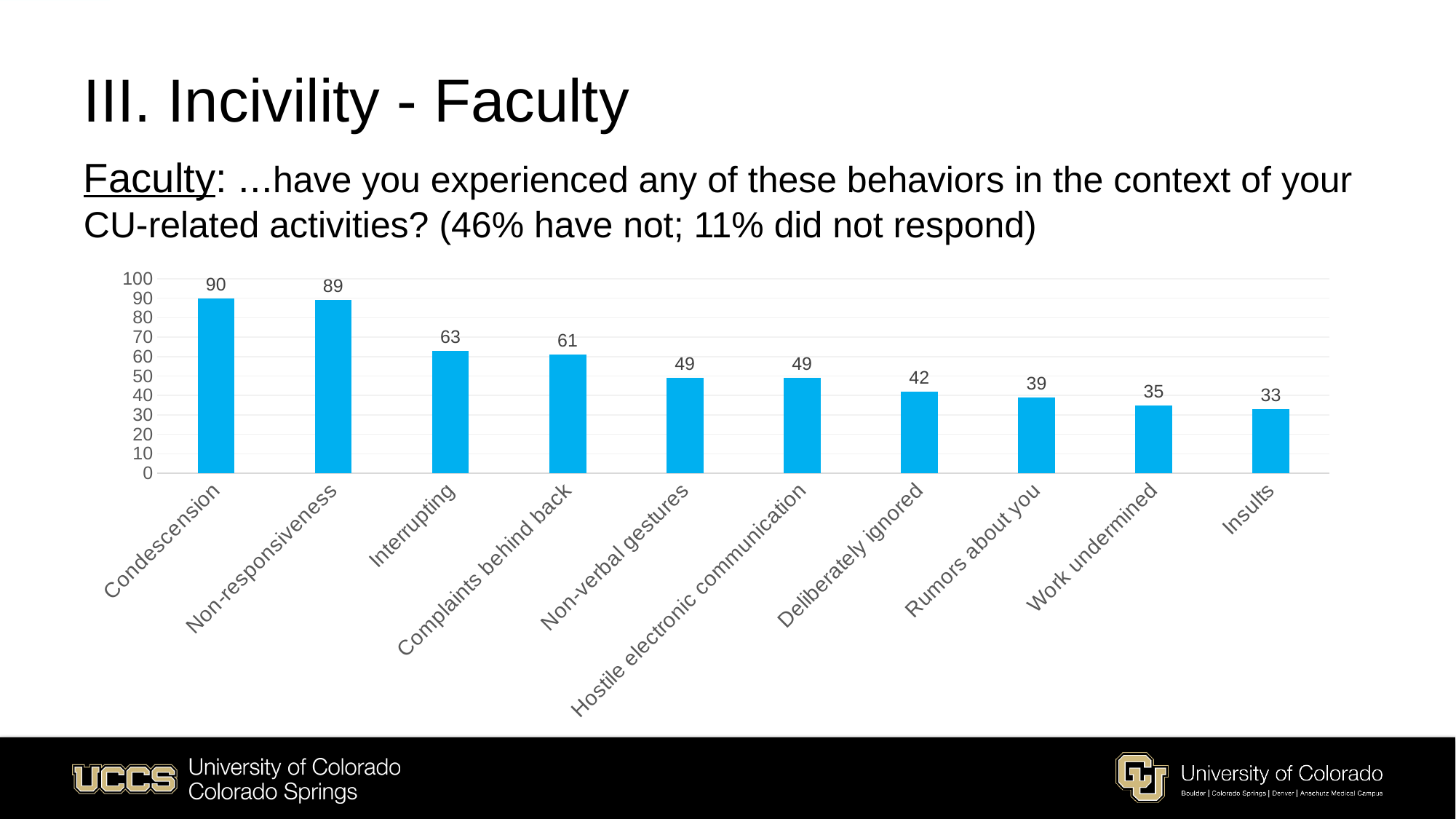
How many categories are shown in the chart? 10 Which category has the highest value? Condescension What is the difference between the values for Non-responsiveness and Deliberately ignored? 47 Do the values rise or fall from left to right along the x axis? fall What is the difference between the values for Interrupting and Insults? 30 What is the value for Hostile electronic communication? 49 Which is larger, the value for Complaints behind back or the value for Rumors about you? Complaints behind back What is the value for Condescension? 90 What kind of chart is shown on the slide? bar chart Is the value for Non-verbal gestures greater or less than 60? less What is the value for Work undermined? 35 Which category has the lowest value? Insults